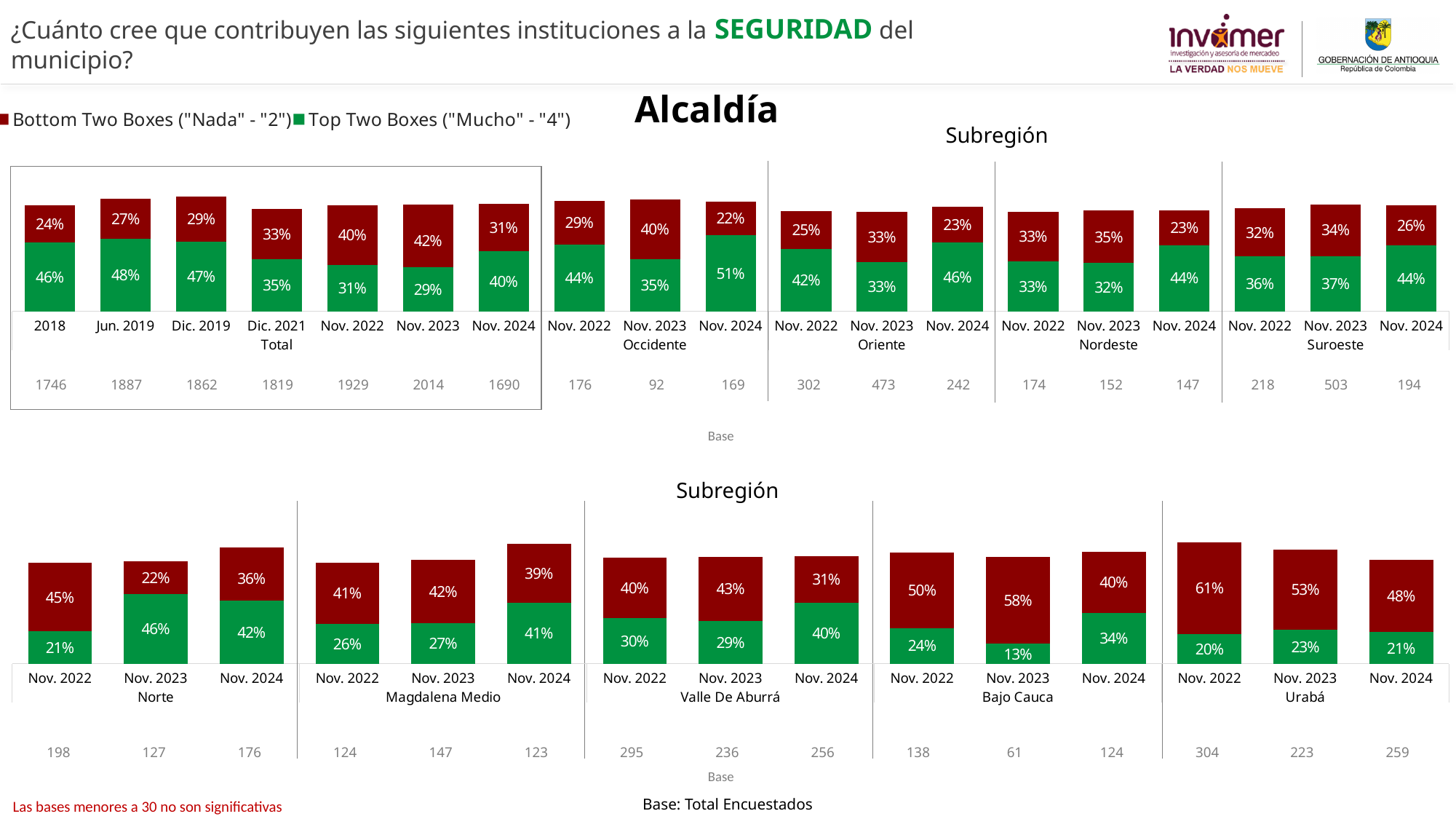
In the top chart, does the Top Two Boxes value for Total rise or fall from Dic. 2019 to Nov. 2023? Fall In the top chart, what is the Top Two Boxes value for Total in Nov. 2024? 40% In the bottom chart, what is the combined total of the Bottom Two Boxes and Top Two Boxes values for Valle De Aburrá in Nov. 2024? 71% In the bottom chart, what is the Top Two Boxes value for Bajo Cauca in Nov. 2023? 13% What kind of chart is used on this slide? Stacked bar chart In the top chart, which Total period has the highest Top Two Boxes value? Jun. 2019 In the top chart, how many periods are shown for Total? 7 How many series does the legend list? 2 In the top chart, what is the difference between the Top Two Boxes values for Occidente in Nov. 2024 and Nov. 2023? 16% In the bottom chart, which is larger for Norte in Nov. 2022: the Bottom Two Boxes value or the Top Two Boxes value? Bottom Two Boxes In the top chart, what is the Bottom Two Boxes value for Occidente in Nov. 2023? 40% In the bottom chart, which Urabá period has the lowest Bottom Two Boxes value? Nov. 2024